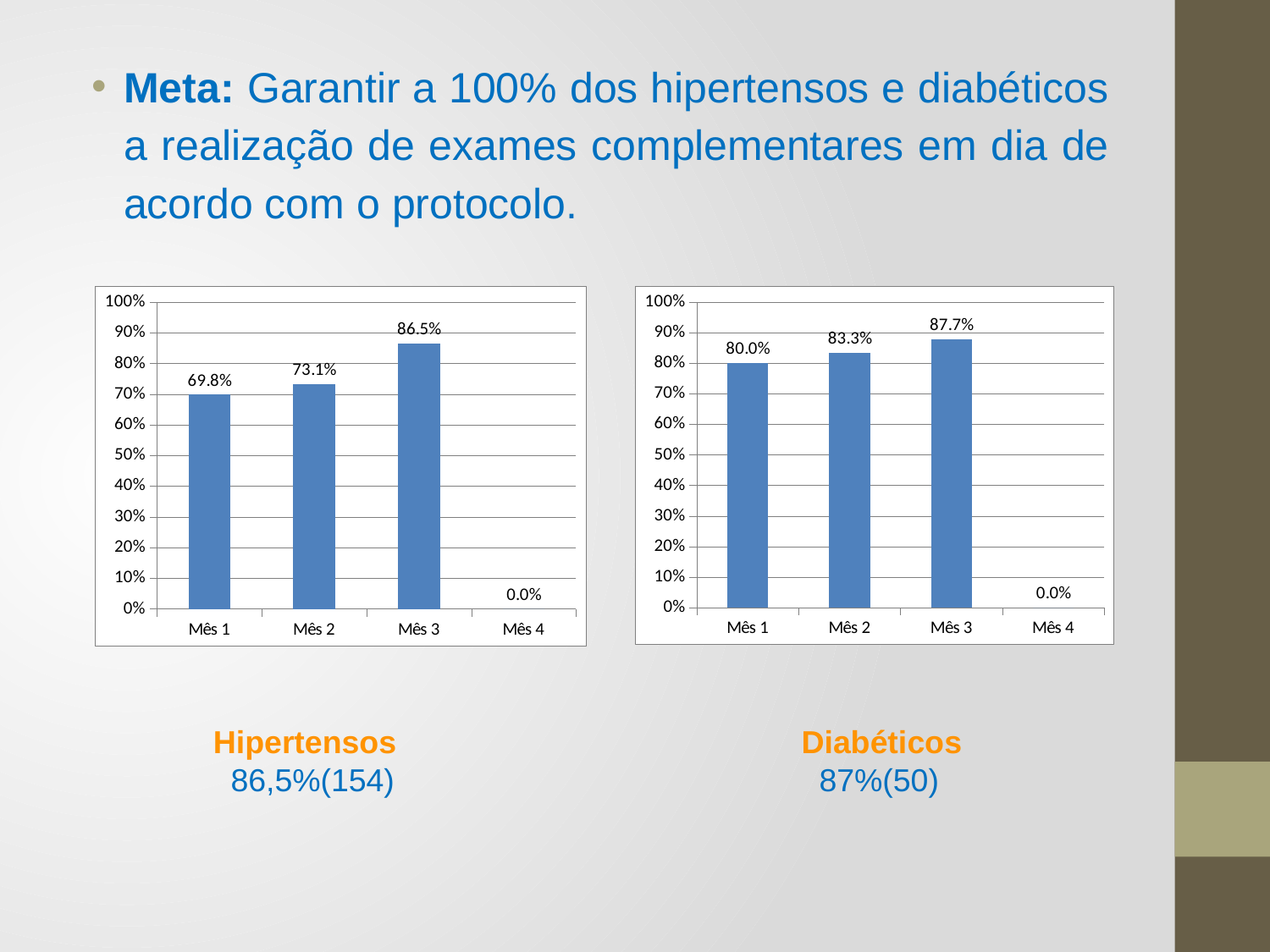
In the left chart (Hipertensos), what is the value for Mês 1? 69.8% What kind of chart is the right chart (Diabéticos)? Bar chart In the right chart (Diabéticos), what is the value for Mês 2? 83.3% In the right chart (Diabéticos), which month has the lowest value? Mês 4 In the left chart (Hipertensos), what is the value for Mês 3? 86.5% In the right chart (Diabéticos), what is the difference between the values for Mês 3 and Mês 2? 4.4% In the left chart (Hipertensos), what is the difference between the values for Mês 3 and Mês 1? 16.7% How many categories are shown on the x axis of the left chart (Hipertensos)? 4 In the right chart (Diabéticos), do the values rise or fall from Mês 1 to Mês 3? Rise In the left chart (Hipertensos), which month has the highest value? Mês 3 In the right chart (Diabéticos), what is the value for Mês 4? 0.0% Which is larger: the Mês 1 value in the left chart (Hipertensos) or the Mês 1 value in the right chart (Diabéticos)? Diabéticos (80.0%)